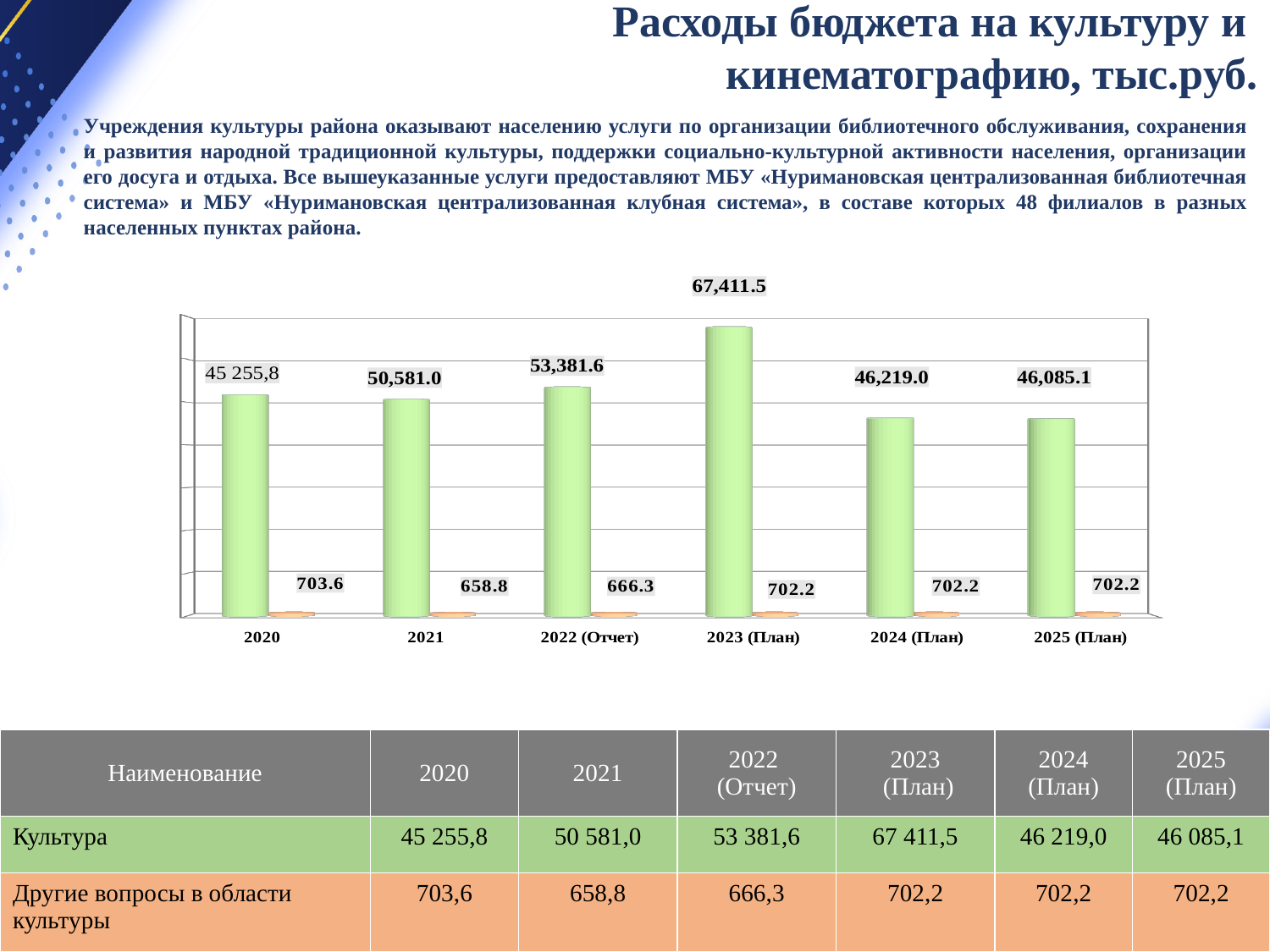
Which year has the highest value for the tall green bars? 2023 (План) How many year categories are shown on the x axis of the chart? 6 What type of chart is shown on the slide? bar chart What is the difference between the orange bar values for 2020 and 2021? 44.8 What is the value of the tall green bar for 2023 (План)? 67,411.5 What is the value of the tall green bar for 2022 (Отчет)? 53,381.6 What is the difference between the green bar values for 2023 (План) and 2022 (Отчет)? 14,029.9 What is the value of the small orange bar for 2020? 703.6 Which year has the lowest value for the small orange bars? 2021 Which is larger, the green bar for 2024 (План) or the green bar for 2025 (План)? 2024 (План) What is the value of the small orange bar for 2021? 658.8